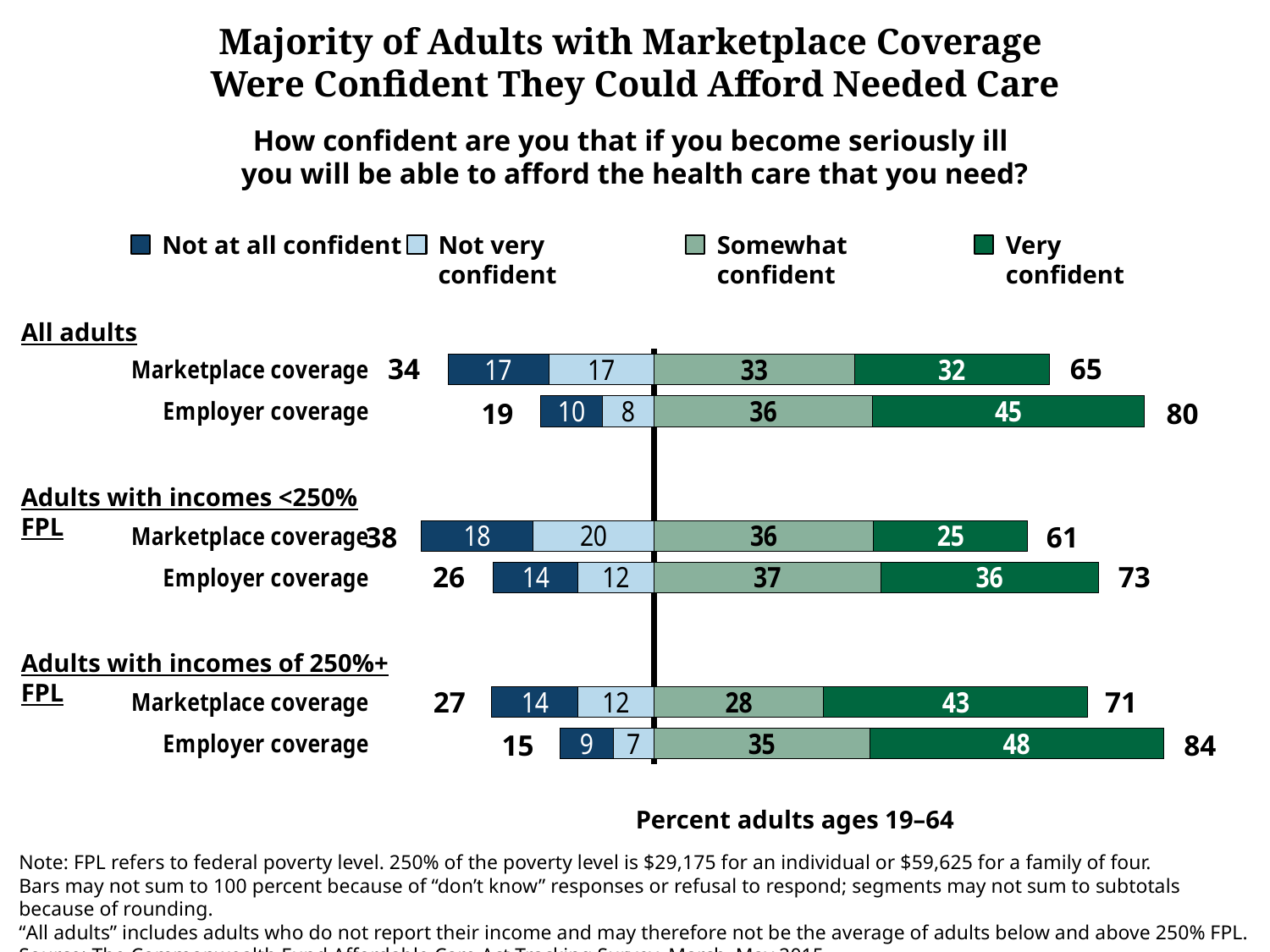
How many bars are plotted in the chart? 6 Which bar has the lowest 'Very confident' value? Marketplace coverage, adults with incomes <250% FPL Among all adults, how much higher is the 'Very confident' value for employer coverage than for marketplace coverage? 13 What percentage of adults with incomes of 250%+ FPL and employer coverage were not very confident? 7 What is the total of the four segments in the bar for employer coverage among adults with incomes of 250%+ FPL? 99 How many series does the legend list? 4 What percentage of adults with incomes <250% FPL and marketplace coverage were not at all confident? 18 What colour represents 'Very confident' in the legend? Dark green What percentage of all adults with employer coverage were very confident they could afford needed care? 45 Which bar has the highest 'Very confident' value? Employer coverage, adults with incomes of 250%+ FPL Which is larger: the 'Somewhat confident' value for employer coverage among adults with incomes <250% FPL, or for marketplace coverage among adults with incomes of 250%+ FPL? Employer coverage, adults with incomes <250% FPL What kind of chart is shown on the slide? Stacked bar chart